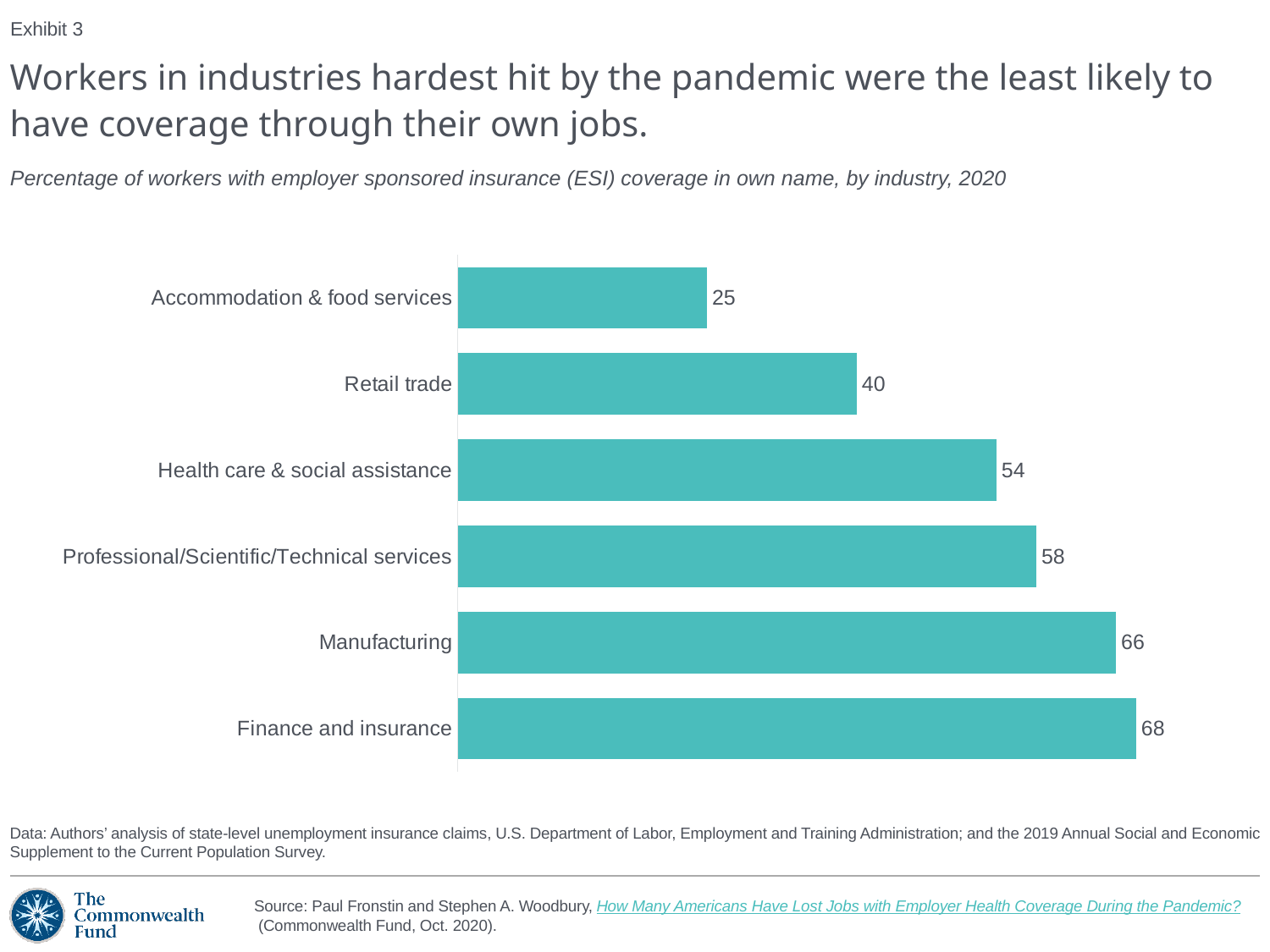
How many industries are shown in the chart? 6 What is the value shown for Health care & social assistance? 54 Which has a higher value, Manufacturing or Health care & social assistance? Manufacturing What is the difference between the values for Professional/Scientific/Technical services and Retail trade? 18 What kind of chart is shown on the slide? Bar chart Which industry has the lowest percentage of workers with ESI coverage in their own name? Accommodation & food services What is the value shown for Manufacturing? 66 What is the difference between the values for Finance and insurance and Accommodation & food services? 43 What year does the chart's data refer to, according to the subtitle? 2020 Which industry has the highest percentage of workers with ESI coverage in their own name? Finance and insurance What is the value shown for Retail trade? 40 What percentage of workers in Accommodation & food services have ESI coverage in their own name? 25